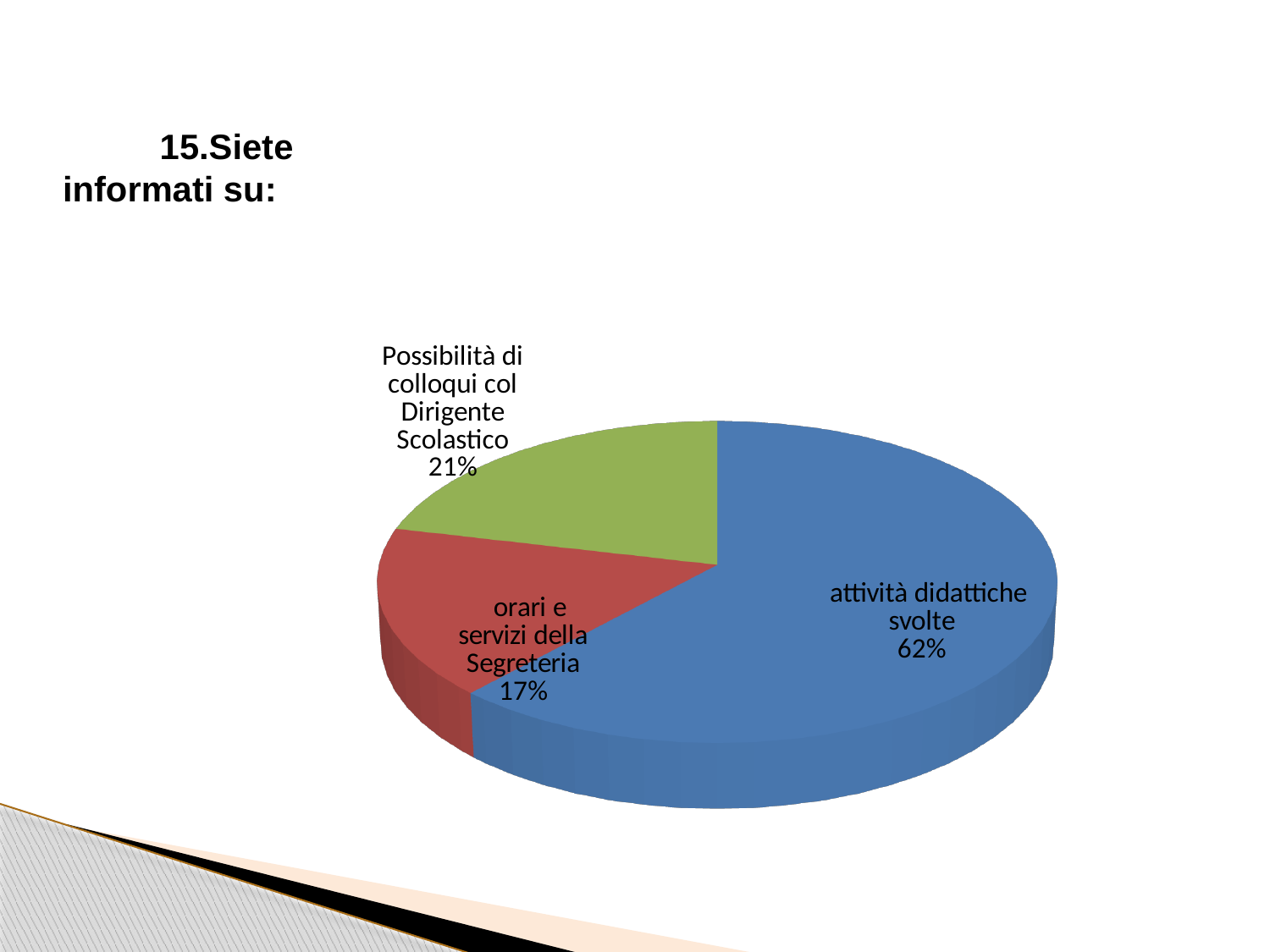
How many slices does the pie chart have? 3 What is the difference in percentage points between "Possibilità di colloqui col Dirigente Scolastico" and "orari e servizi della Segreteria"? 4 What percentage of the pie is labelled "Possibilità di colloqui col Dirigente Scolastico"? 21% Which is larger: the slice for "orari e servizi della Segreteria" or the slice for "Possibilità di colloqui col Dirigente Scolastico"? Possibilità di colloqui col Dirigente Scolastico What percentage of the pie is labelled "attività didattiche svolte"? 62% What colour is the slice for "attività didattiche svolte"? blue What percentage of the pie is labelled "orari e servizi della Segreteria"? 17% Which slice of the pie is the smallest? orari e servizi della Segreteria Which slice of the pie is the largest? attività didattiche svolte What is the difference in percentage points between "attività didattiche svolte" and "Possibilità di colloqui col Dirigente Scolastico"? 41 What kind of chart is shown on the slide? pie chart What is the title text shown above the chart on the slide? 15.Siete informati su: